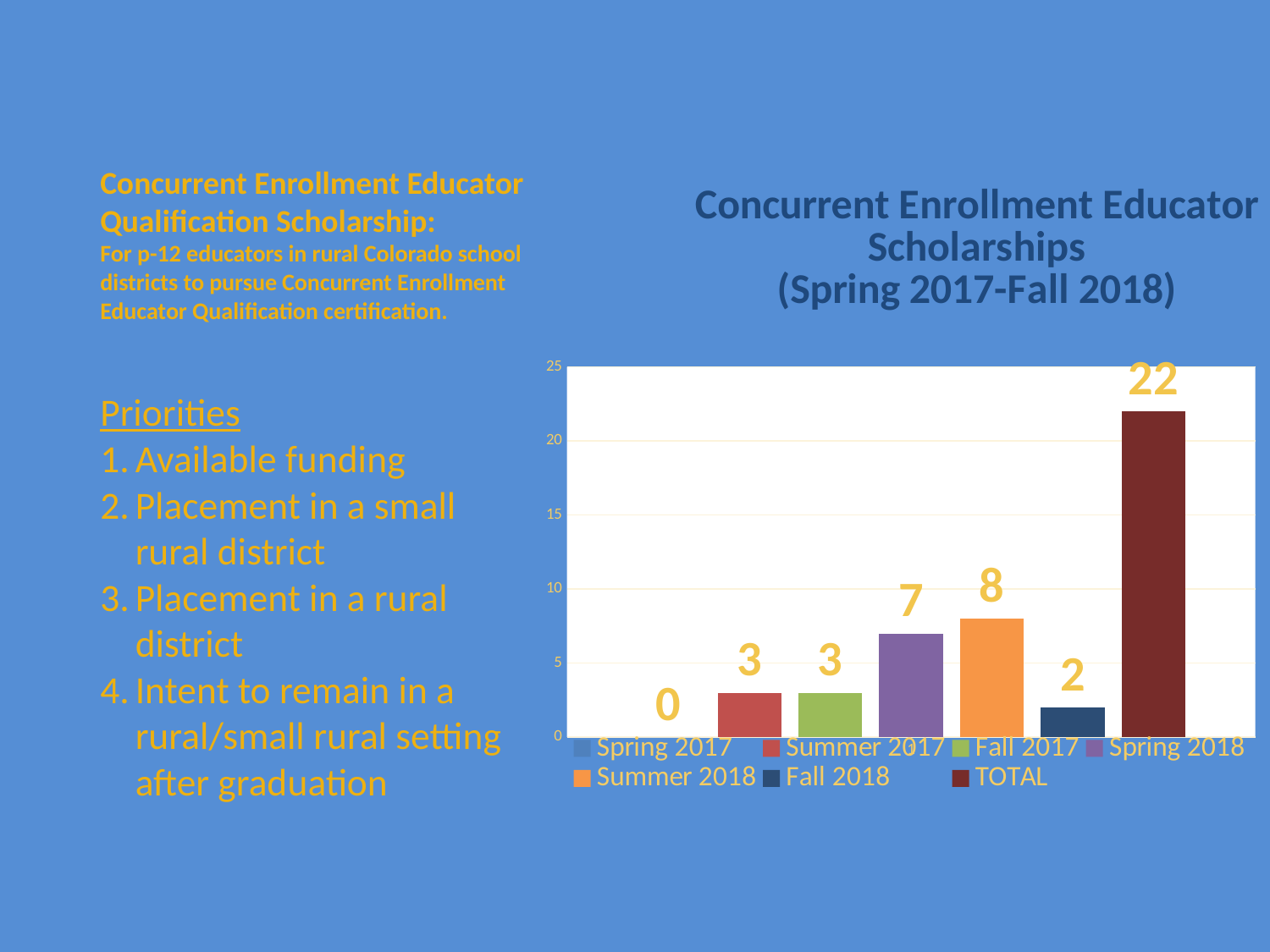
What is the value for Spring 2017? 0 What type of chart is shown on the slide? bar chart What is the value of the TOTAL bar? 22 What is the title of the chart? Concurrent Enrollment Educator Scholarships (Spring 2017-Fall 2018) What is the value for Fall 2018? 2 What is the value for Summer 2018? 8 Which legend entry has the lowest value? Spring 2017 Which legend entry has the highest value? TOTAL How many entries does the chart's legend list? 7 What is the difference between the values for Summer 2018 and Fall 2018? 6 Which is larger, the value for Spring 2018 or the value for Summer 2017? Spring 2018 What is the value for Spring 2018? 7